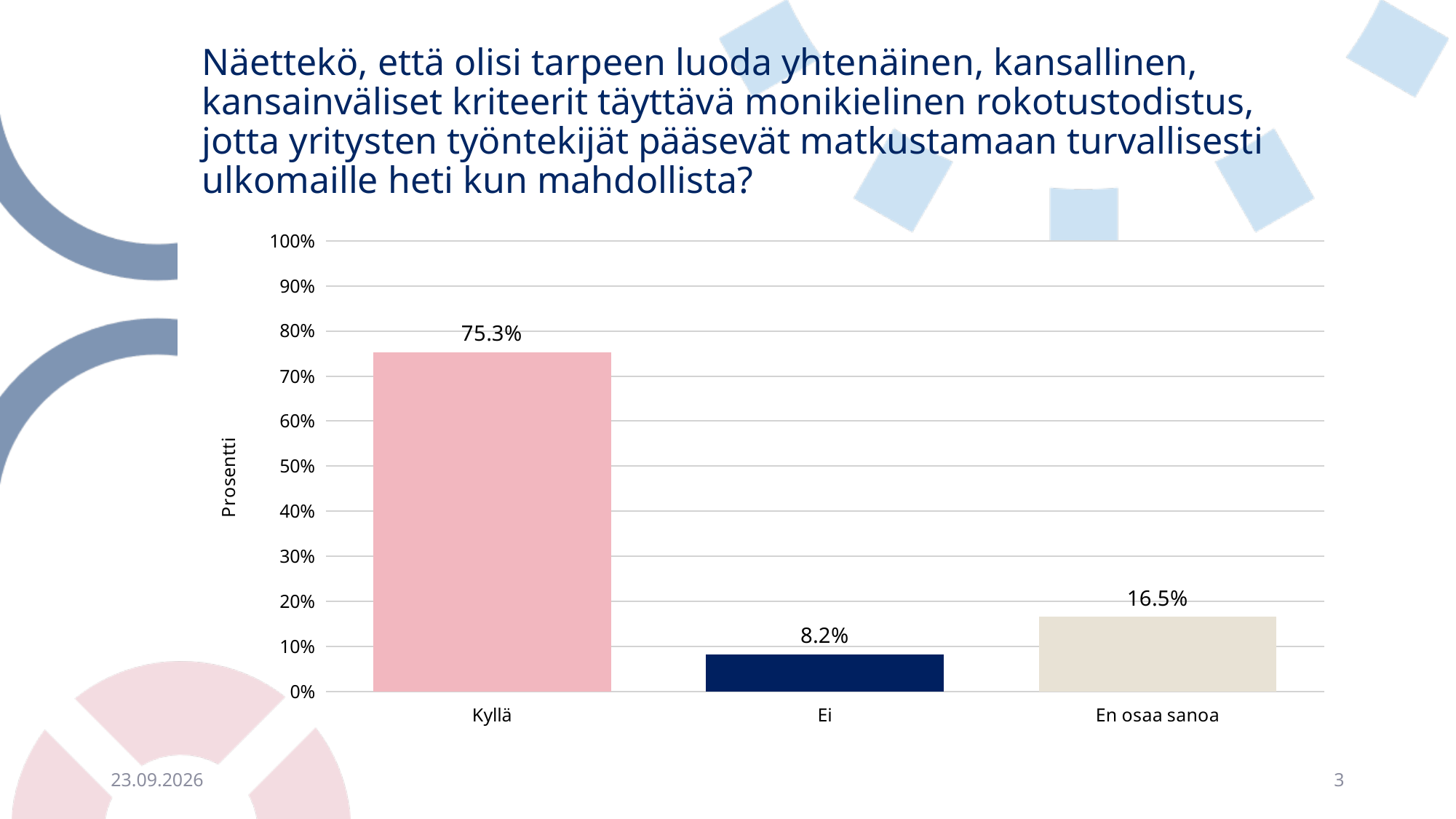
What kind of chart is shown on the slide? bar chart What is the value for En osaa sanoa? 16.5% What is the value for Kyllä? 75.3% What is the label of the vertical axis? Prosentti What is the difference between the values for Kyllä and En osaa sanoa? 58.8% What is the difference between the values for En osaa sanoa and Ei? 8.3% How many categories are shown on the x axis? 3 Which is larger, the value for Ei or the value for En osaa sanoa? En osaa sanoa What is the value for Ei? 8.2% Which category has the highest value? Kyllä Which category has the lowest value? Ei Is the value for Kyllä greater or less than 70%? greater